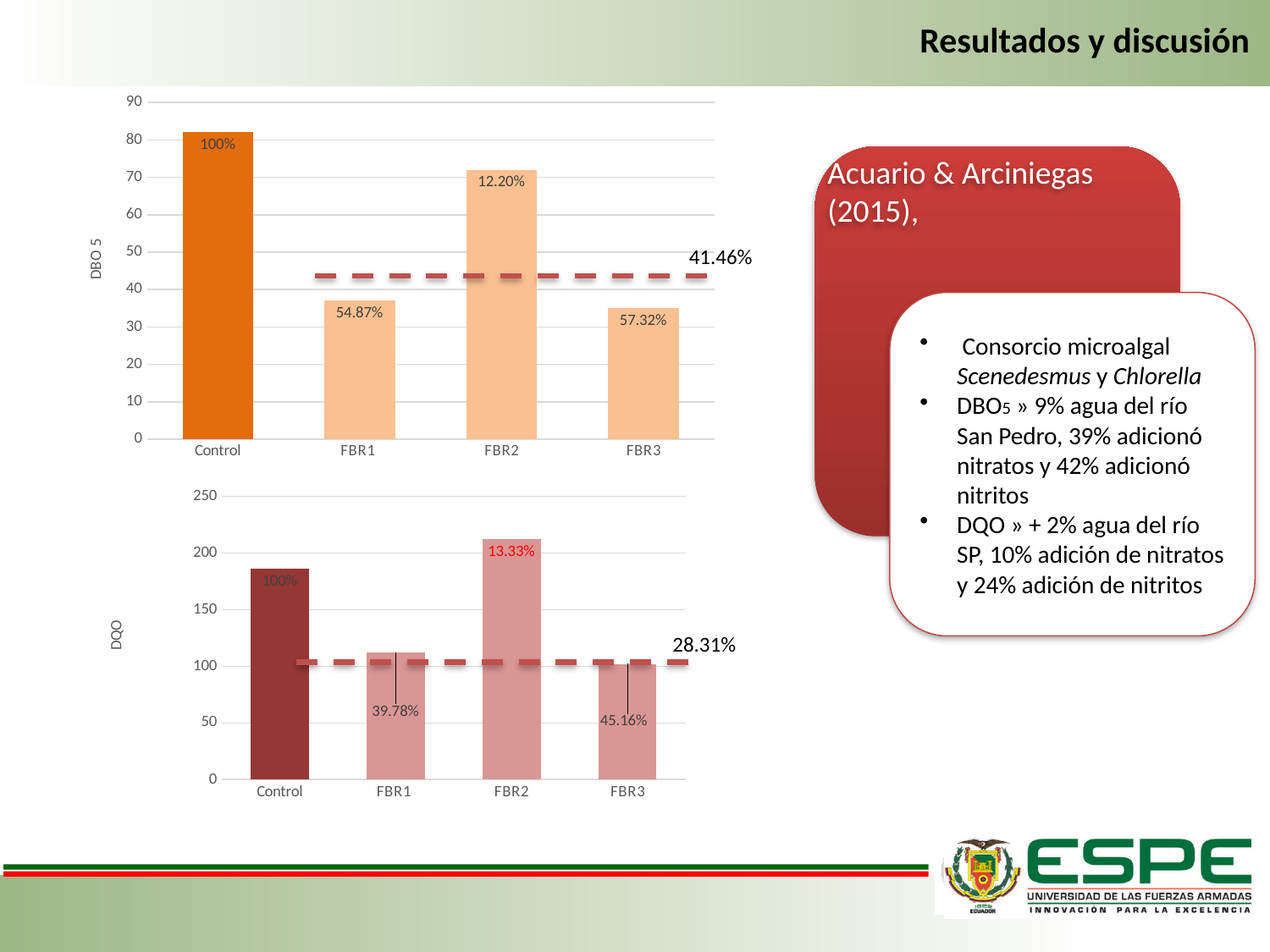
In the bottom chart (DQO), what percentage label is shown on the FBR1 bar? 39.78% How many categories are shown on the x axis of the bottom chart (DQO)? 4 In the top chart (DBO 5), what percentage label is shown on the FBR1 bar? 54.87% What value is labelled next to the dashed line in the top chart (DBO 5)? 41.46% In the bottom chart (DQO), what percentage label is shown on the FBR3 bar? 45.16% In the bottom chart (DQO), is the bar for FBR2 greater or less than 200? greater In the top chart (DBO 5), what percentage label is shown on the FBR3 bar? 57.32% In the top chart (DBO 5), is the bar for FBR1 greater or less than 40? less In the bottom chart (DQO), which category has the tallest bar? FBR2 In the top chart (DBO 5), what percentage label is shown on the FBR2 bar? 12.20% In the top chart (DBO 5), which category has the tallest bar? Control In the bottom chart (DQO), what percentage label is shown on the FBR2 bar? 13.33%